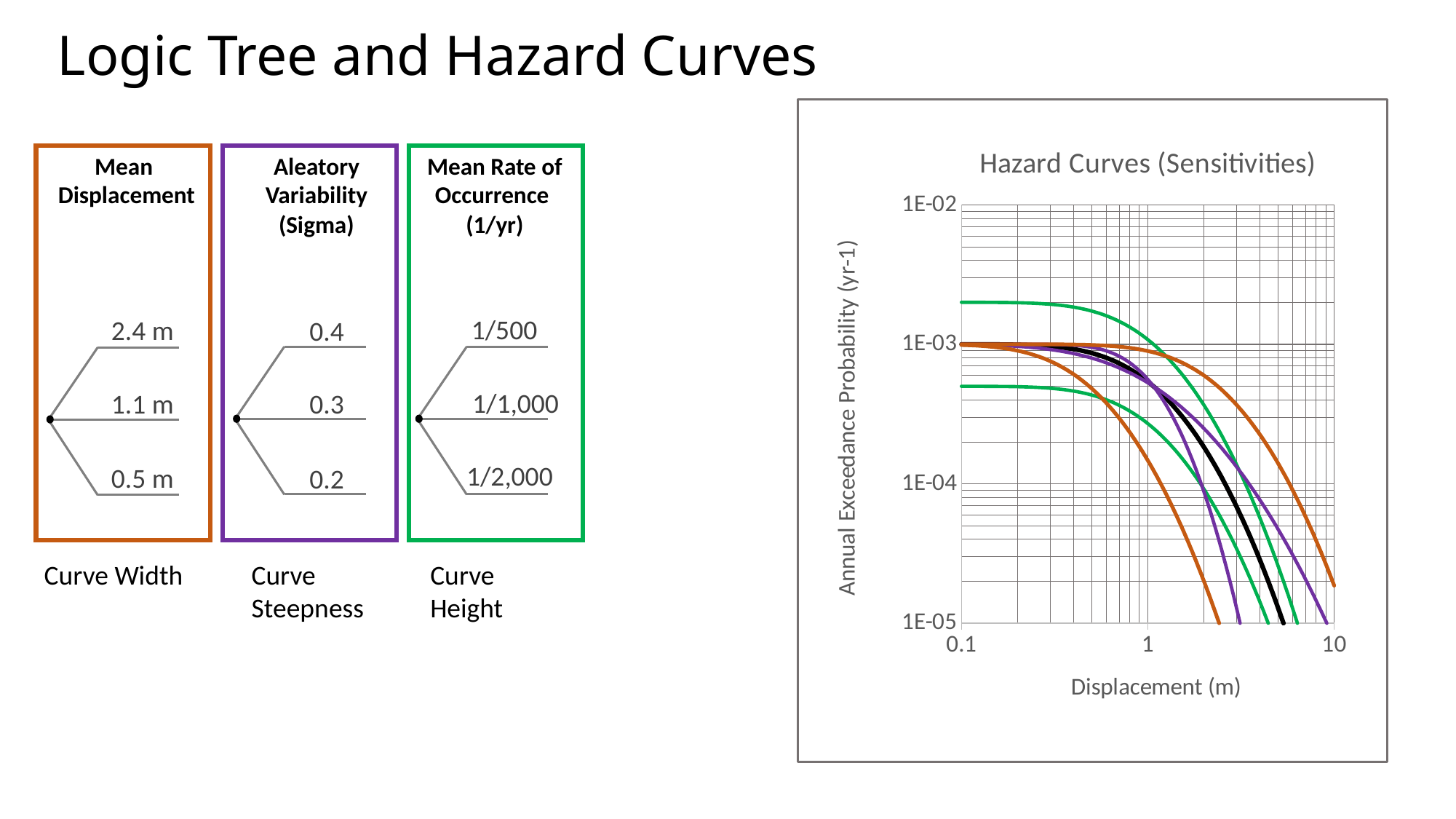
Is the value of the lower green curve at a displacement of 0.1 m greater or less than 1E-03? less What is the largest displacement value labelled on the x axis of the chart? 10 What is the title of the chart on the slide? Hazard Curves (Sensitivities) What is the highest value labelled on the y axis of the chart? 1E-02 Is the value of the black curve at a displacement of 1 m greater or less than 1E-03? less What kind of chart is shown on the slide? line chart What is the lowest value labelled on the y axis of the chart? 1E-05 At a displacement of 0.1 m, which curve has the highest annual exceedance probability: the upper green curve or the black curve? the upper green curve Is the value of the upper green curve at a displacement of 0.1 m greater or less than 1E-03? greater Do the curves in the chart rise or fall as displacement increases? fall How many curves are plotted in the chart? 7 What is the label of the x axis of the chart? Displacement (m)